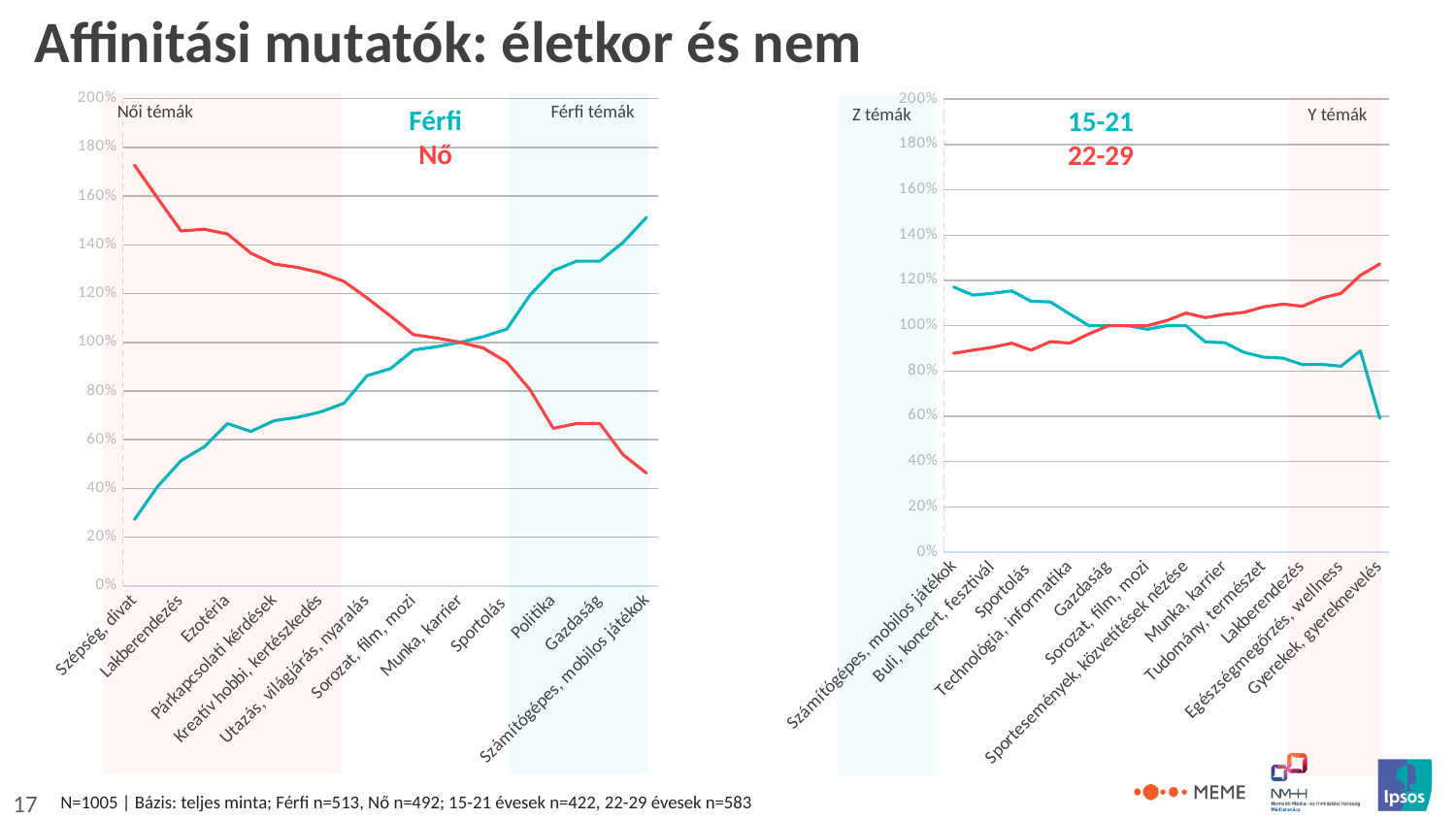
How many series does the legend of the right chart list? 2 In the left chart, for which category is the Nő series highest? Szépség, divat In the right chart, which series has the larger value for Számítógépes, mobilos játékok, 15-21 or 22-29? 15-21 In the left chart, which series has the larger value for Politika, Férfi or Nő? Férfi What kind of chart is the left chart (Férfi / Nő)? line chart In the left chart, does the Férfi series rise or fall from left to right along the x axis? rise In the left chart, is the Férfi value for Számítógépes, mobilos játékok greater or less than 140%? greater In the left chart, is the Férfi value for Szépség, divat greater or less than 40%? less In the left chart, is the Nő value for Szépség, divat greater or less than 160%? greater